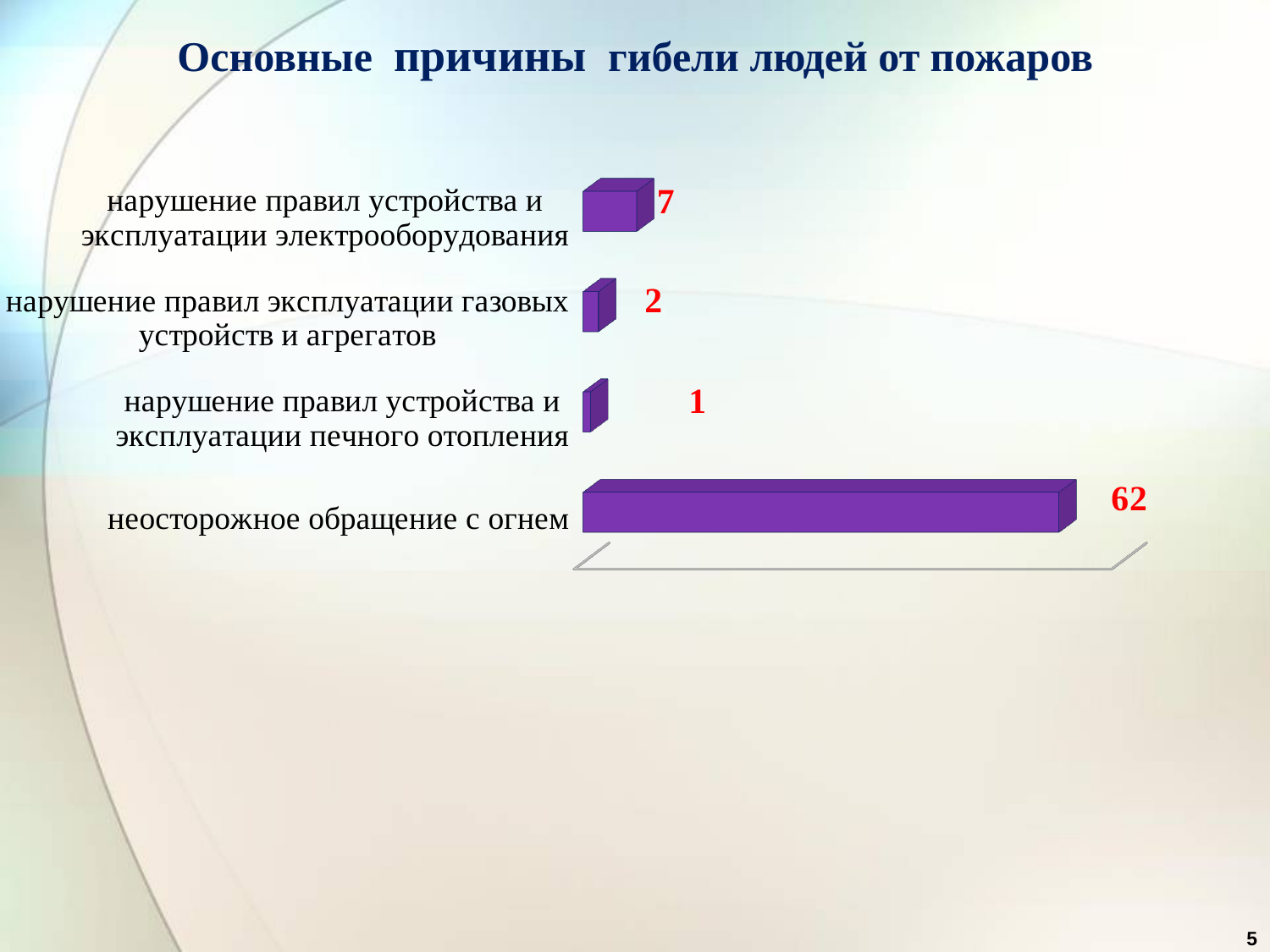
Which category has the highest value? неосторожное обращение с огнем What is the value for "неосторожное обращение с огнем"? 62 What is the title of the slide? Основные причины гибели людей от пожаров What is the value for "нарушение правил устройства и эксплуатации электрооборудования"? 7 What is the value for "нарушение правил эксплуатации газовых устройств и агрегатов"? 2 Which is larger: the value for "нарушение правил эксплуатации газовых устройств и агрегатов" or for "нарушение правил устройства и эксплуатации печного отопления"? нарушение правил эксплуатации газовых устройств и агрегатов Which category has the lowest value? нарушение правил устройства и эксплуатации печного отопления What is the difference between the values for "нарушение правил устройства и эксплуатации электрооборудования" and "нарушение правил эксплуатации газовых устройств и агрегатов"? 5 What is the value for "нарушение правил устройства и эксплуатации печного отопления"? 1 What is the difference between the values for "неосторожное обращение с огнем" and "нарушение правил устройства и эксплуатации электрооборудования"? 55 What kind of chart is shown on the slide? bar chart How many categories are shown in the chart? 4